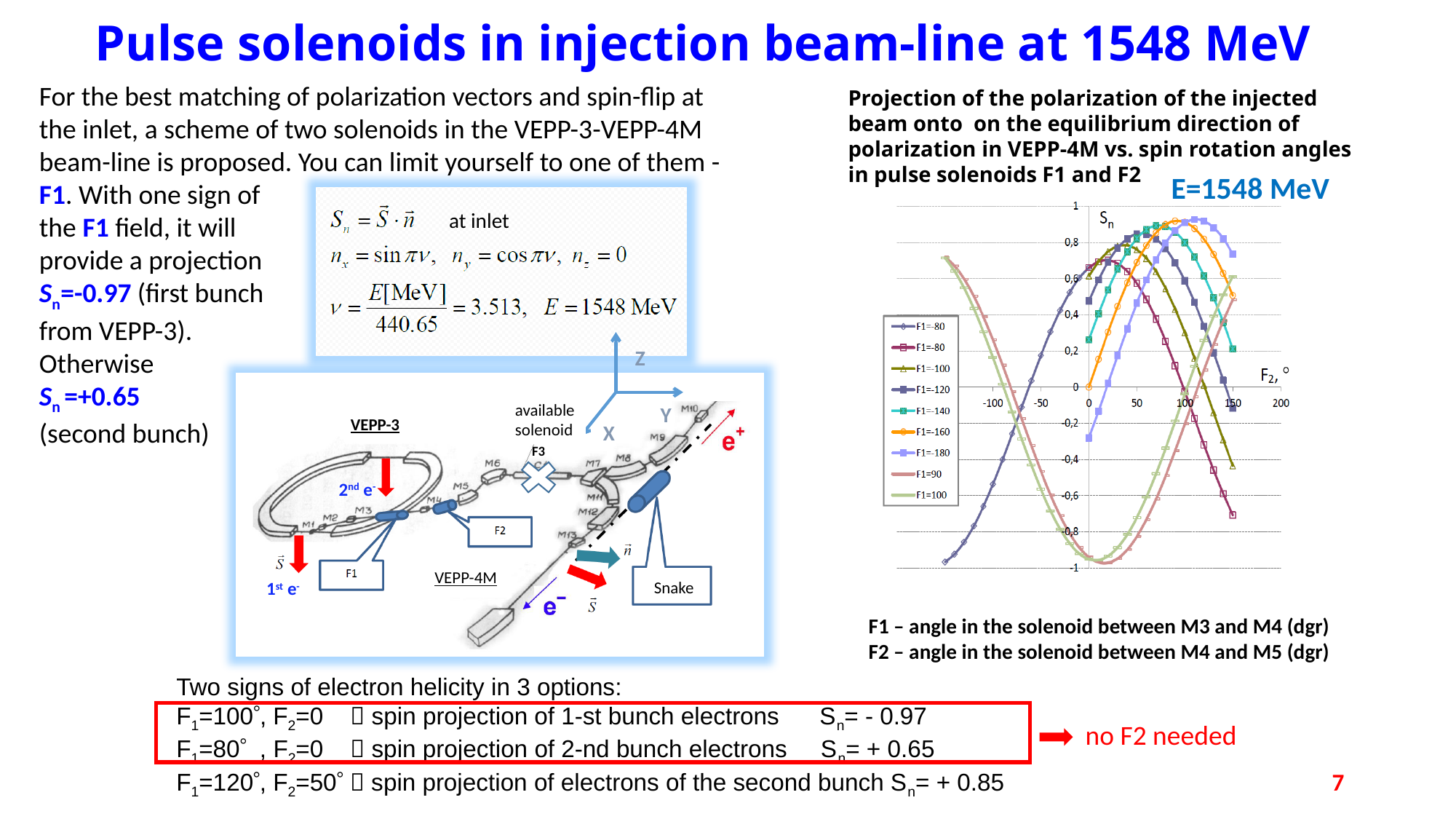
What is the lowest tick value shown on the horizontal axis of the chart? -100 At F2=150, which curve has the larger value: F1=-80 or F1=-180? F1=-180 Does the F1=-180 curve rise or fall as F2 goes from 0 to 100? rise Is the peak value of the F1=-180 curve greater or less than 0.8? greater What is the label of the horizontal axis of the chart? F2, ° What is the highest tick value shown on the vertical axis of the chart? 1 What kind of chart is shown on the right side of the slide? line chart Does the F1=90 curve rise or fall as F2 goes from 0 to 150? rise What energy value is written above the chart? E=1548 MeV Is the value of the F1=90 curve at F2=0 greater or less than -0.8? less Is the value of the F1=-80 curve at F2=150 greater or less than -0.4? less How many series does the legend of the chart list? 9